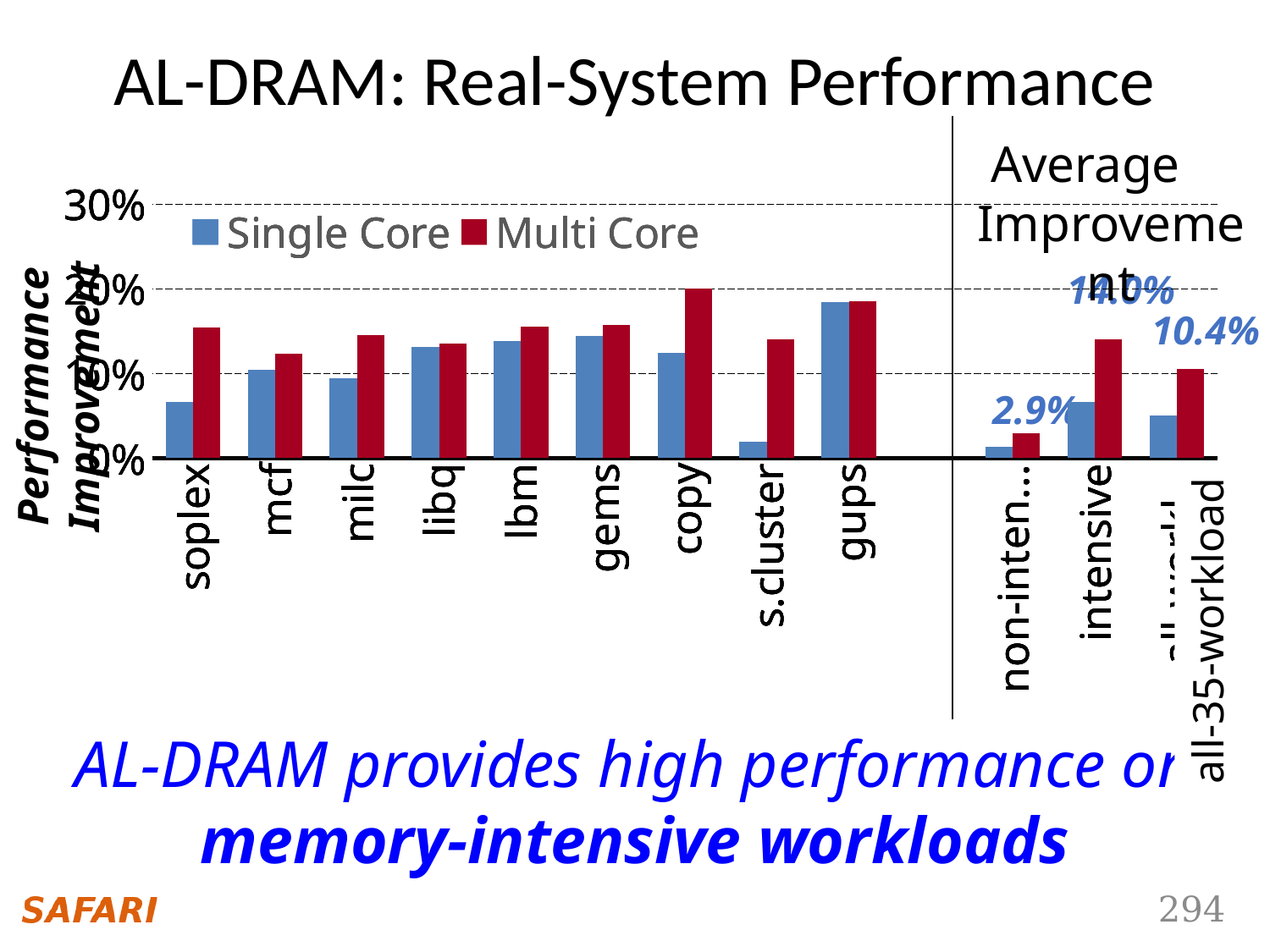
What are the two series named in the legend? Single Core and Multi Core Which of the nine benchmarks has the lowest Single Core performance improvement? s.cluster Which benchmark has the highest Single Core performance improvement? gups What average improvement value is labelled for the non-intensive workloads? 2.9% Is the Single Core value for s.cluster greater or less than 10%? less How many individual benchmark categories are plotted to the left of the vertical divider line? 9 Is the Multi Core value for gups greater or less than 10%? greater What average improvement value is labelled for the intensive workloads? 14.0% What average improvement value is labelled for all-35-workload? 10.4% How many series does the legend list? 2 For s.cluster, which is larger: the Single Core or the Multi Core value? Multi Core What kind of chart is shown on the slide? bar chart